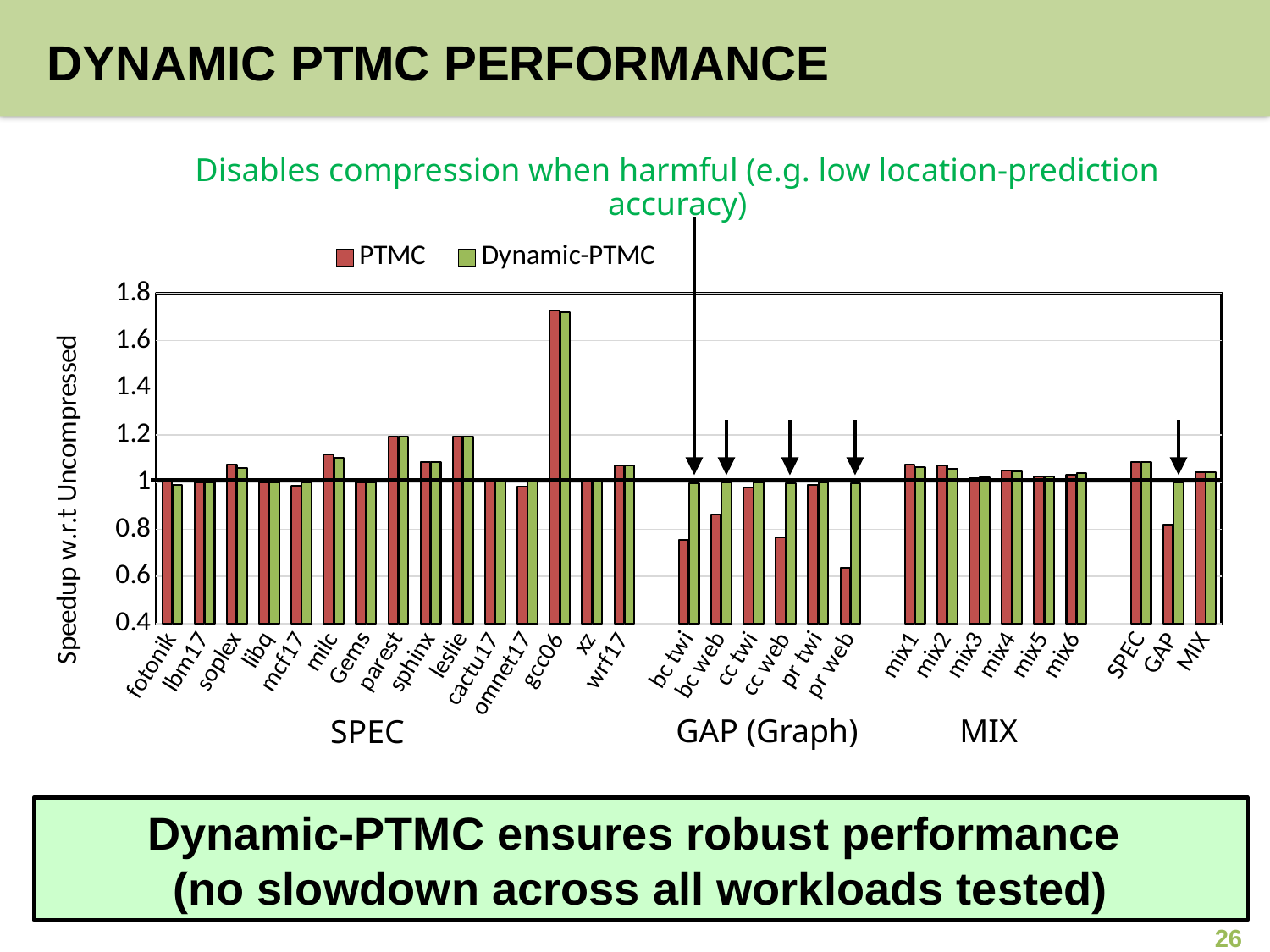
What is the label of the y axis? Speedup w.r.t Uncompressed What kind of chart is shown on the slide? bar chart Is the PTMC value for pr web greater or less than 0.8? less Which workload has the highest PTMC speedup? gcc06 Is the PTMC value for gcc06 greater or less than 1.6? greater What are the two series named in the legend? PTMC and Dynamic-PTMC For pr web, which is larger: the PTMC value or the Dynamic-PTMC value? Dynamic-PTMC Is the PTMC value for the GAP summary bar greater or less than 1? less Which workload has the lowest PTMC speedup? pr web How many workloads are plotted in the GAP (Graph) group? 6 How many series does the legend list? 2